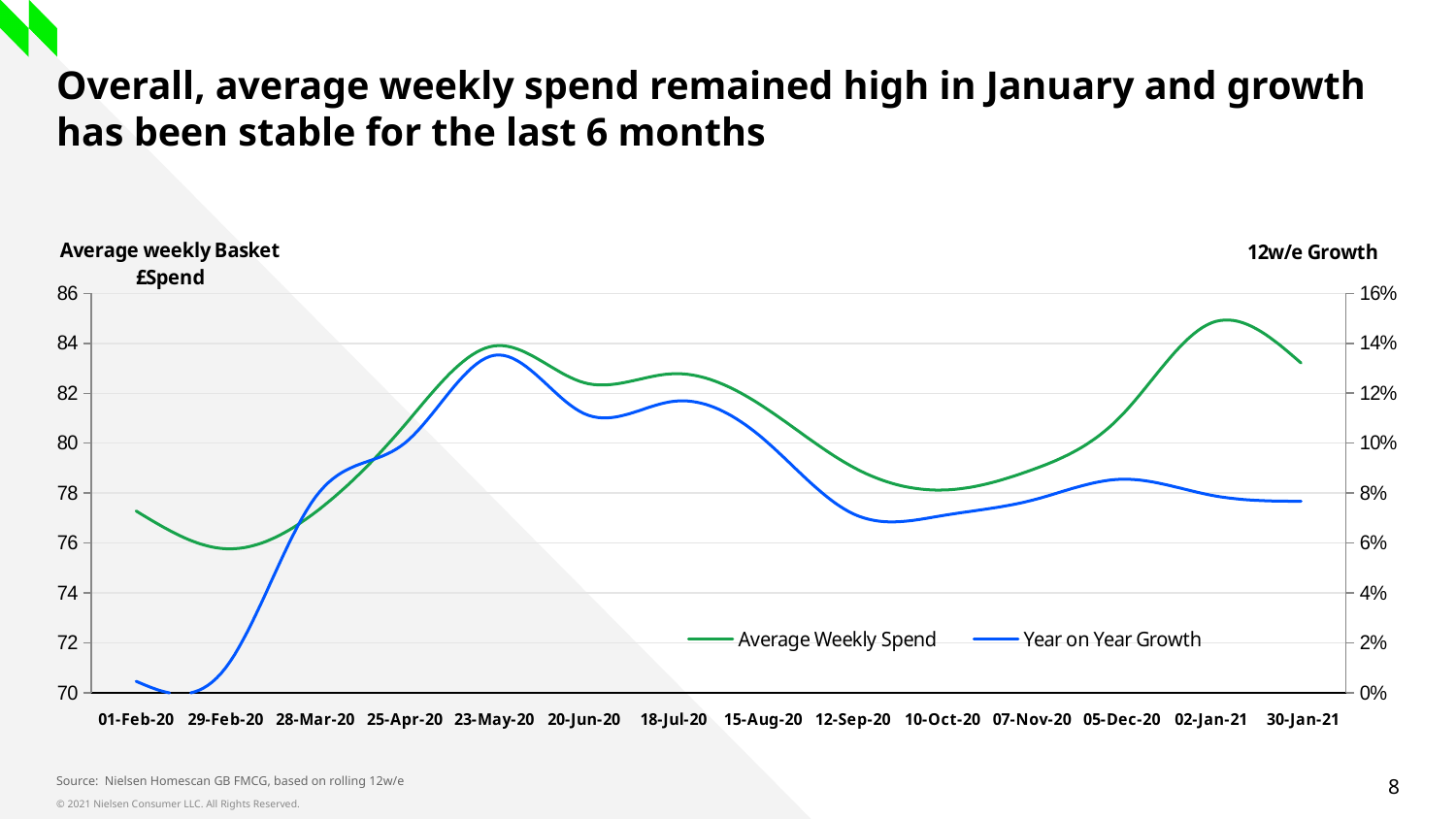
What kind of chart is shown on the slide? Line chart What is the title of the right-hand vertical axis of the chart? 12w/e Growth At which x-axis date does the Average Weekly Spend line reach its highest point? 02-Jan-21 How many series does the chart legend list? 2 Does the Average Weekly Spend line rise or fall between 10-Oct-20 and 02-Jan-21? rise Is the Year on Year Growth value at 29-Feb-20 greater or less than 2%? less Is the Average Weekly Spend value at 10-Oct-20 greater or less than 80? less Is the Year on Year Growth value at 23-May-20 greater or less than 12%? greater Is Average Weekly Spend higher at 23-May-20 or at 12-Sep-20? 23-May-20 How many date labels are shown along the x axis of the chart? 14